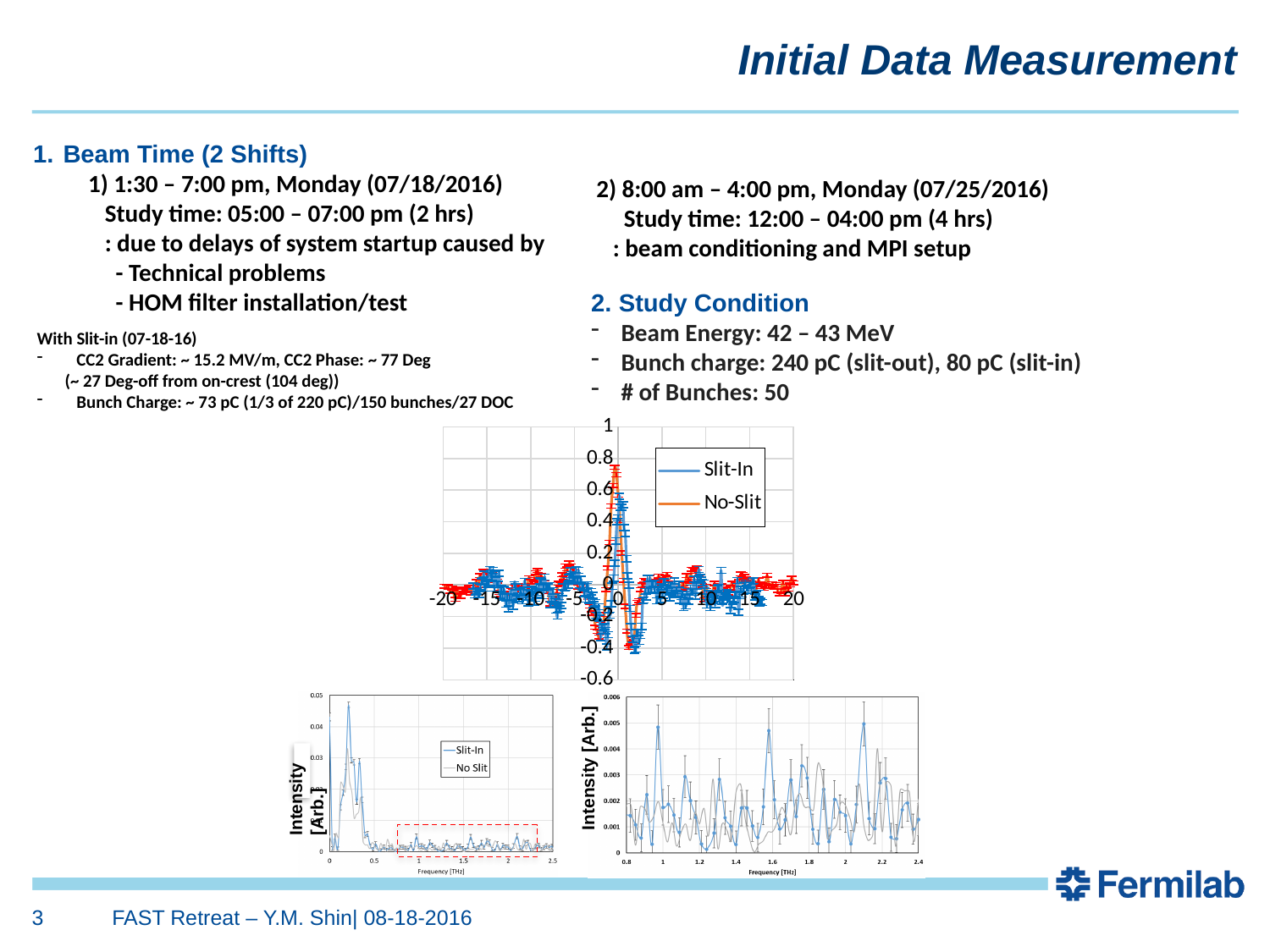
In the top chart, is the peak value of the No-Slit series greater or less than 1? less How many series does the legend of the bottom-left chart list? 2 In the bottom-left chart, is the highest value of the Slit-In series greater or less than 0.04? greater In the bottom-left chart, is the highest value of the Slit-In series greater or less than 0.05? less What is the x-axis label of the bottom-left chart? Frequency [THz] What kind of chart is the top chart on the slide? line chart How many series does the legend of the top chart list? 2 What are the two series named in the legend of the top chart? Slit-In and No-Slit What kind of chart is the bottom-right chart on the slide? line chart